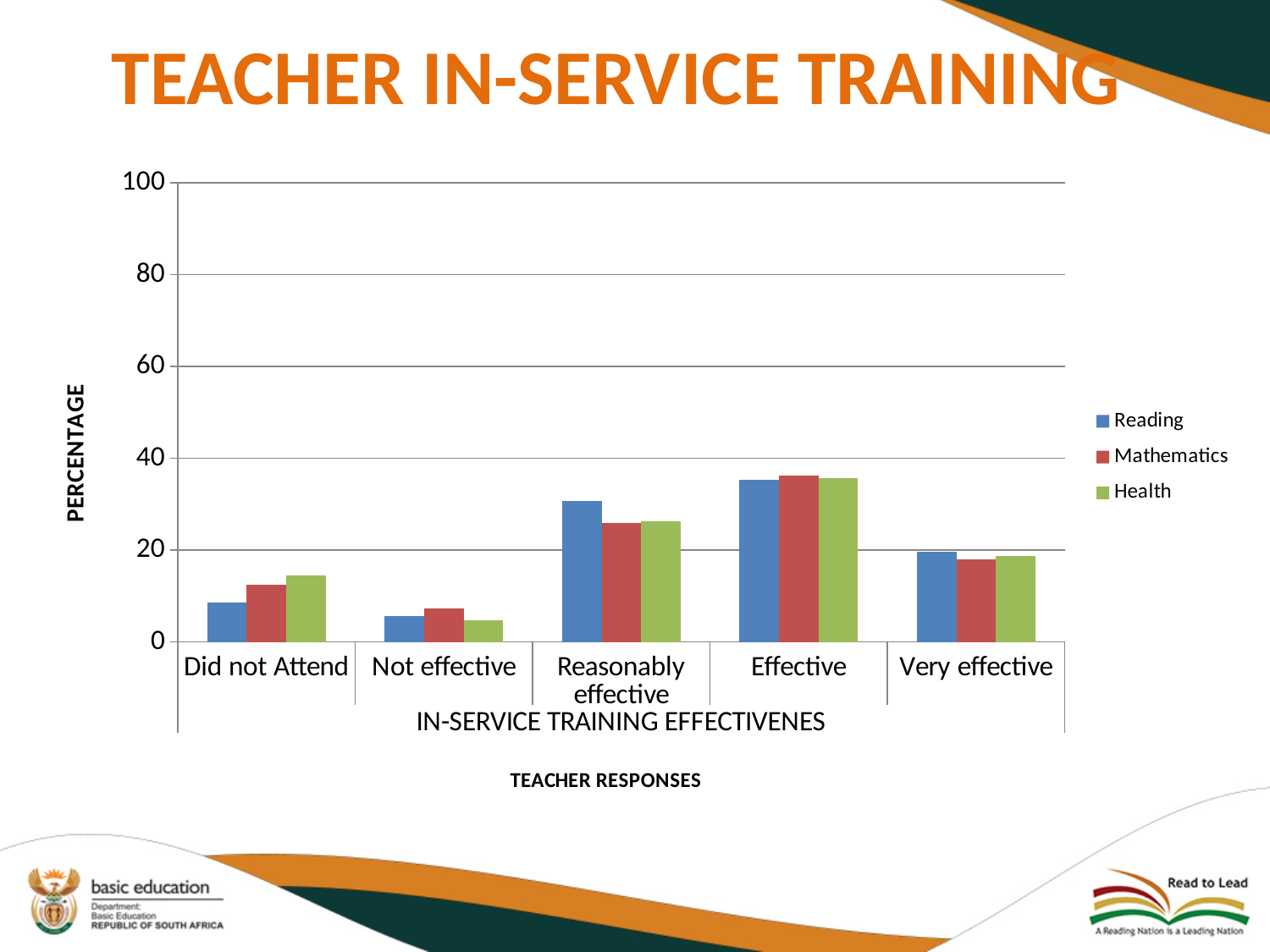
Is the Mathematics value for Reasonably effective greater or less than 40? less Is the Health value for Did not Attend greater or less than 20? less For the Health series, which category has the lowest value? Not effective For the Reading series, which category has the lowest value? Not effective For the Reading series, which category has the highest value? Effective What kind of chart is shown on the slide? Bar chart What is the title of the vertical axis? PERCENTAGE For Reasonably effective, which is larger: the Reading value or the Mathematics value? Reading How many series does the legend list? 3 For the Health series, which category has the highest value? Effective How many response categories are shown on the x axis? 5 Is the Reading value for Effective greater or less than 20? greater